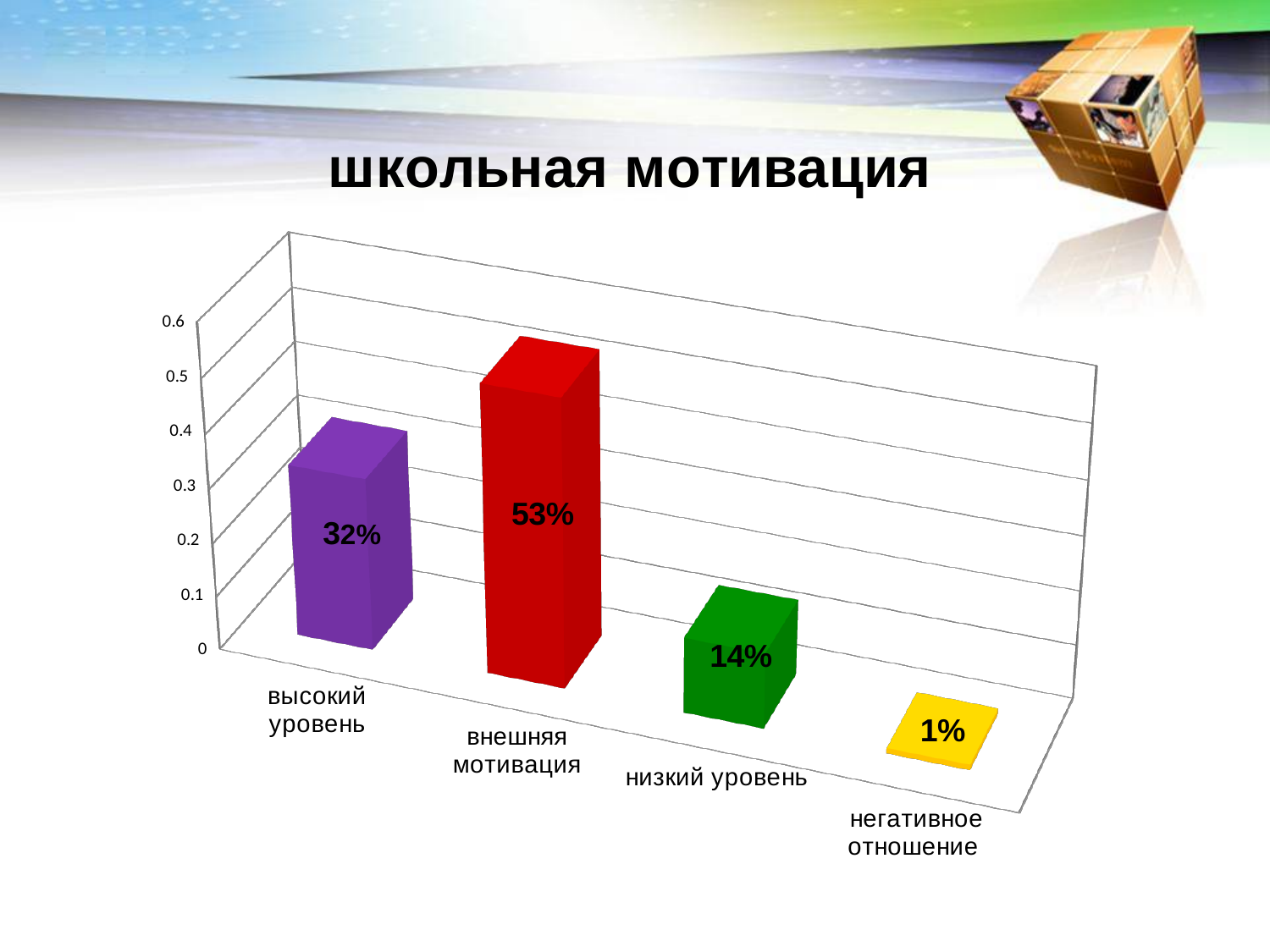
What is the value for низкий уровень? 14% What is the title of the slide? школьная мотивация Which category has the highest value? внешняя мотивация What is the value for внешняя мотивация? 53% What colour is the bar for внешняя мотивация? red What is the value for негативное отношение? 1% What kind of chart is shown on the slide? bar chart What is the value for высокий уровень? 32% What is the difference between the values for внешняя мотивация and высокий уровень? 21% How many categories are shown in the chart? 4 Which is larger, the value for высокий уровень or the value for низкий уровень? высокий уровень Which category has the lowest value? негативное отношение